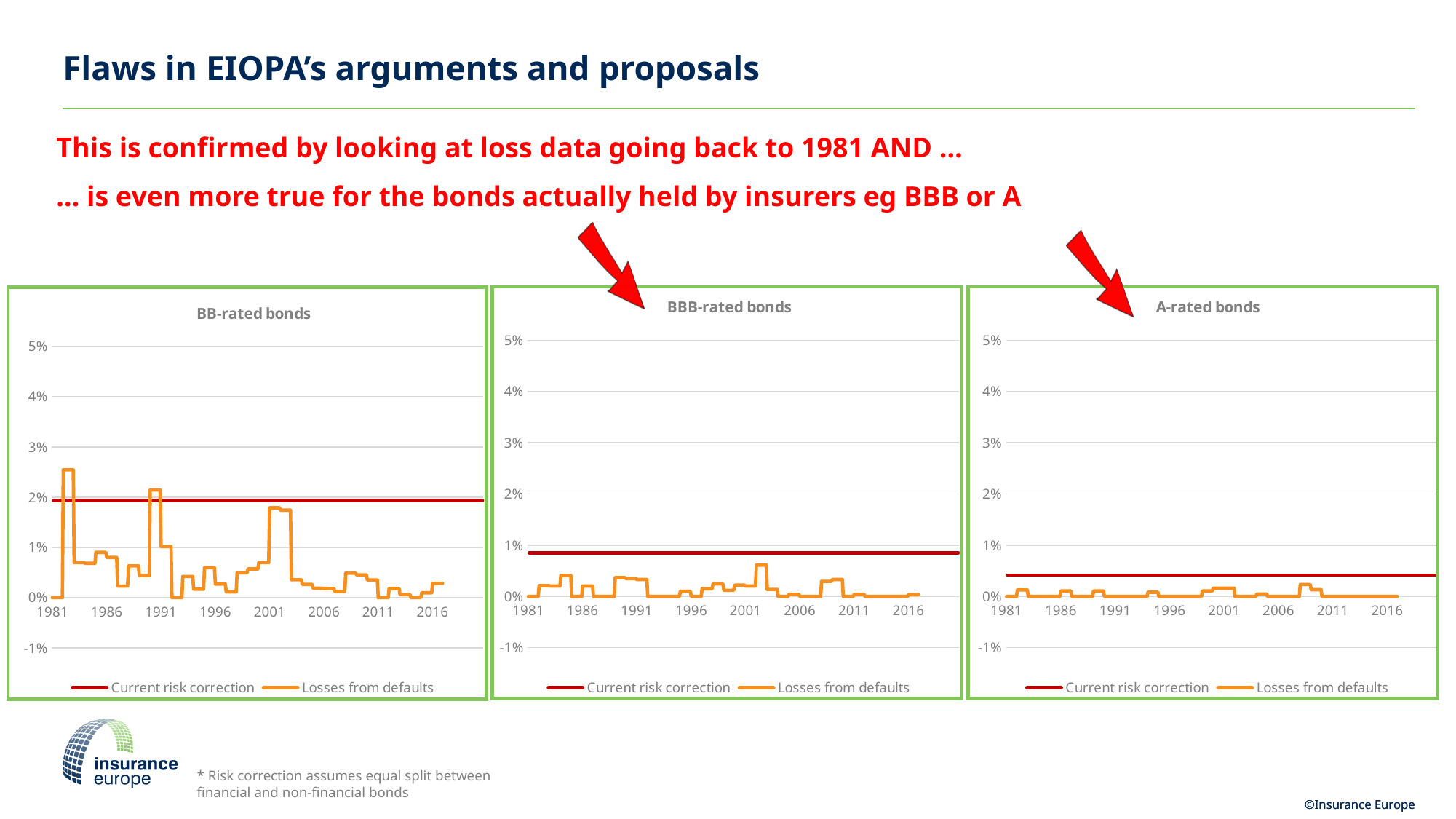
How many series does the legend of the "BBB-rated bonds" chart list? 2 In the "BB-rated bonds" chart, is the peak value of Losses from defaults greater or less than 2%? greater In the "A-rated bonds" chart, which series is higher for most of the period: Current risk correction or Losses from defaults? Current risk correction What are the two series named in the legend of the "A-rated bonds" chart? Current risk correction; Losses from defaults Which of the three charts shows the highest Current risk correction line? BB-rated bonds In the "BBB-rated bonds" chart, is the value of the Current risk correction line greater or less than 1%? less What colour is the Losses from defaults line in the charts? orange What kind of chart is the "BB-rated bonds" chart? line chart In the "BBB-rated bonds" chart, is the highest value of Losses from defaults greater or less than 1%? less How many charts are shown on the slide? 3